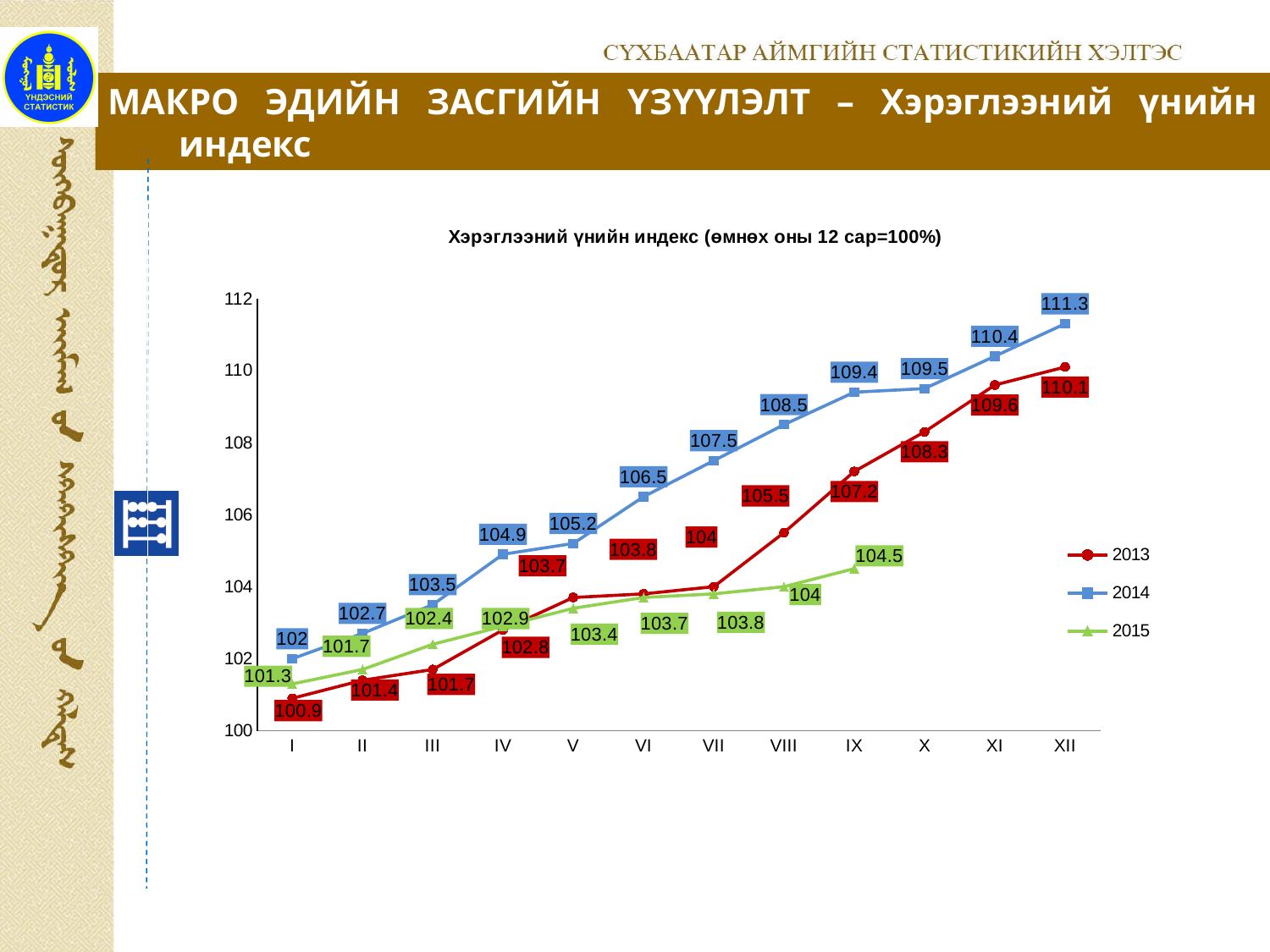
What type of chart is shown on the slide? line chart In which month is the 2013 series at its lowest? I Which is larger in month IV: the 2014 value or the 2015 value? 2014 How many months are plotted for the 2015 series? 9 Does the 2013 series rise or fall from month I to month XII? rise What is the value for 2013 in month VIII? 105.5 What is the title of the chart? Хэрэглээний үнийн индекс (өмнөх оны 12 сар=100%) What is the value for 2015 in month IX? 104.5 What is the value for 2014 in month XII? 111.3 What is the difference between the 2014 and 2013 values in month XII? 1.2 How many series does the legend list? 3 In which month is the 2014 series at its highest? XII